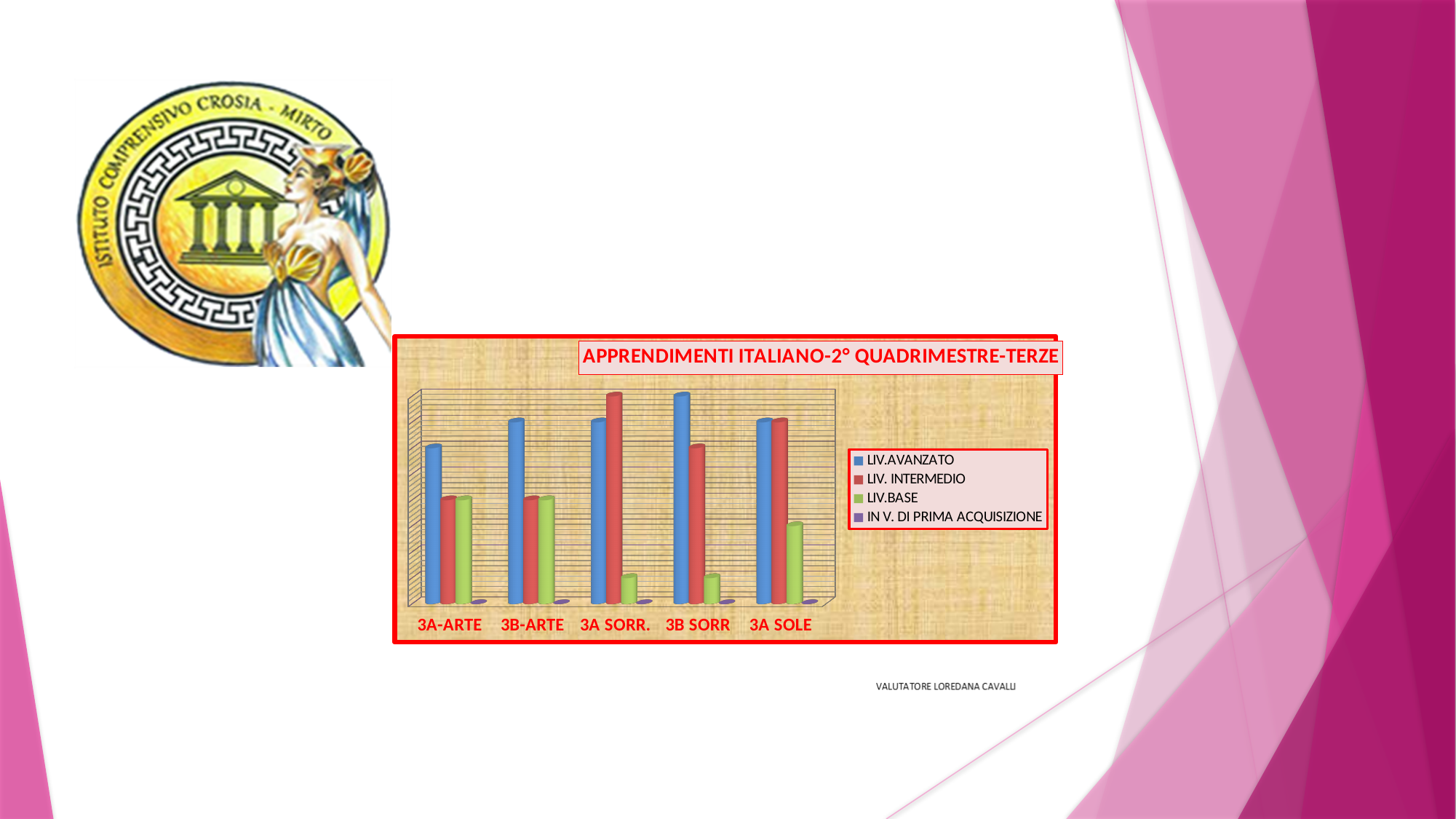
For 3A-ARTE, which is larger: LIV.AVANZATO or LIV.BASE? LIV.AVANZATO How many series does the chart legend list? 4 How many categories (classes) are shown on the x axis of the chart? 5 Which series has the lowest value in every class shown? IN V. DI PRIMA ACQUISIZIONE What kind of chart is shown on the slide? bar chart For 3A SORR., which is larger: LIV.AVANZATO or LIV. INTERMEDIO? LIV. INTERMEDIO Which class has the lowest LIV.AVANZATO bar? 3A-ARTE What is the title of the chart? APPRENDIMENTI ITALIANO-2° QUADRIMESTRE-TERZE Which colour represents LIV.BASE in the chart? green For 3B SORR, which is larger: LIV.AVANZATO or LIV. INTERMEDIO? LIV.AVANZATO Which class has the highest LIV. INTERMEDIO bar? 3A SORR. Which class has the highest LIV.AVANZATO bar? 3B SORR